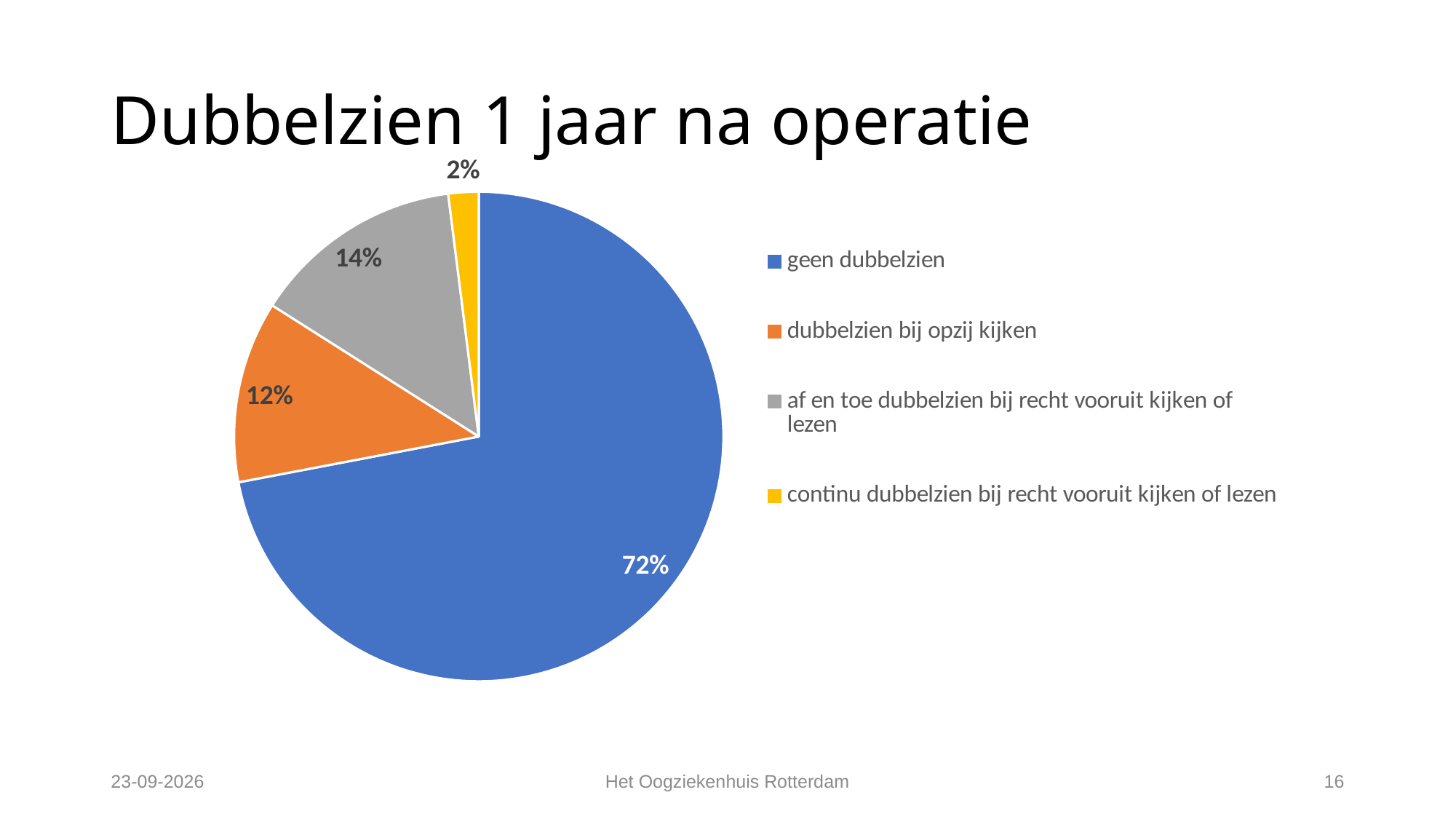
Which category has the smallest slice of the pie? continu dubbelzien bij recht vooruit kijken of lezen What type of chart is shown on the slide? pie chart What percentage is shown for 'dubbelzien bij opzij kijken'? 12% What is the title of the slide containing the chart? Dubbelzien 1 jaar na operatie What percentage is shown for 'continu dubbelzien bij recht vooruit kijken of lezen'? 2% Which is larger: the slice for 'dubbelzien bij opzij kijken' or the slice for 'af en toe dubbelzien bij recht vooruit kijken of lezen'? af en toe dubbelzien bij recht vooruit kijken of lezen What is the difference in percentage points between 'geen dubbelzien' and 'af en toe dubbelzien bij recht vooruit kijken of lezen'? 58 What percentage is shown for 'af en toe dubbelzien bij recht vooruit kijken of lezen'? 14% How many slices does the pie chart have? 4 What colour is the slice for 'geen dubbelzien'? blue Which category has the largest slice of the pie? geen dubbelzien What share of the pie is labelled 'geen dubbelzien'? 72%